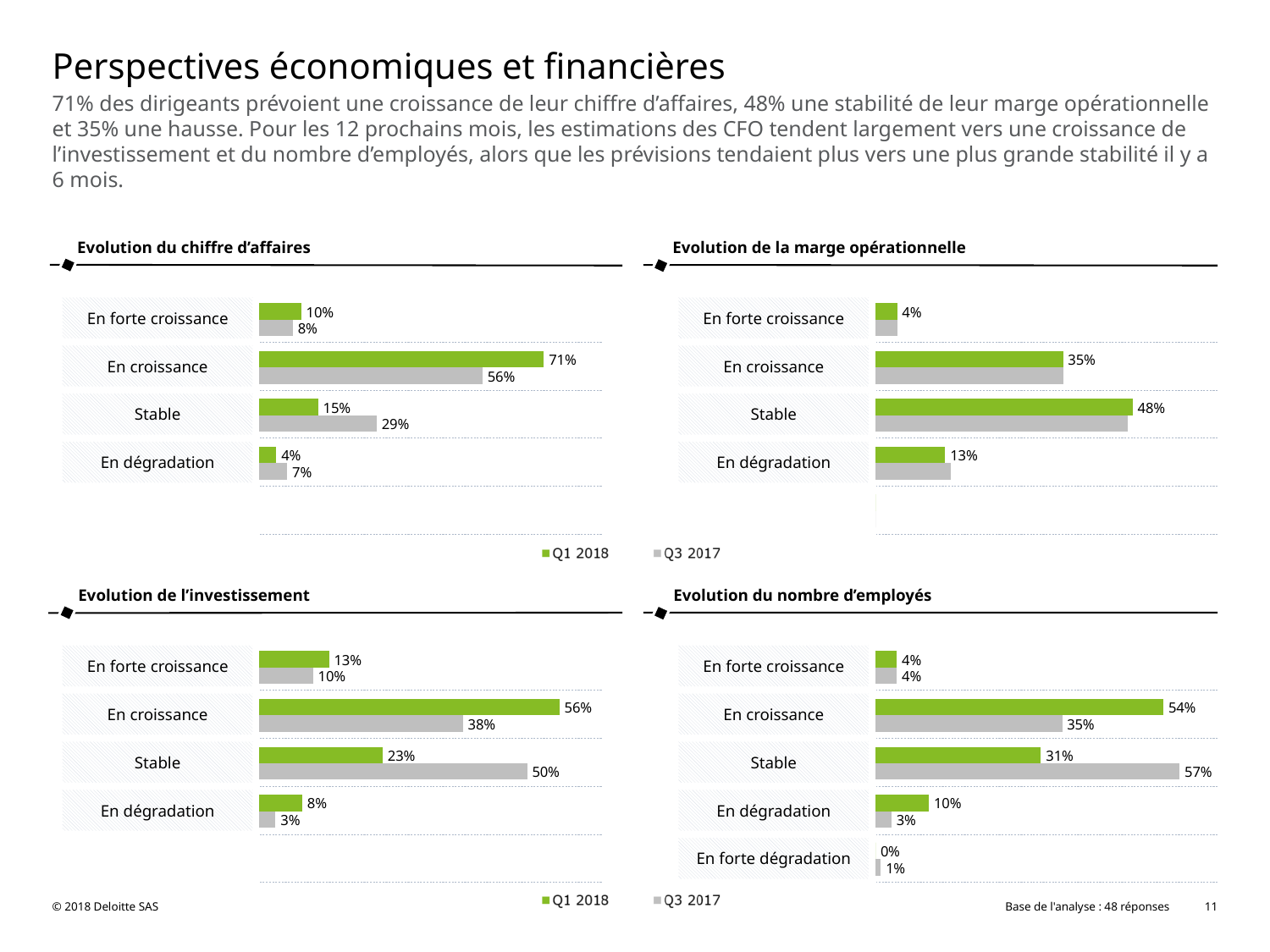
In the 'Evolution du nombre d'employés' chart, what is the Q3 2017 value for 'Stable'? 57% In the 'Evolution de la marge opérationnelle' chart, what is the Q1 2018 value for 'En dégradation'? 13% In the 'Evolution du chiffre d'affaires' chart, what is the Q3 2017 value for 'Stable'? 29% How many series does the legend list for the 'Evolution de l'investissement' chart? 2 In the 'Evolution de la marge opérationnelle' chart, which category has the highest Q1 2018 value? Stable How many categories does the 'Evolution du nombre d'employés' chart show? 5 In the 'Evolution du nombre d'employés' chart, what is the difference between the Q3 2017 and Q1 2018 values for 'Stable'? 26% In the 'Evolution de l'investissement' chart, which is larger for 'En croissance': the Q1 2018 value or the Q3 2017 value? Q1 2018 In the 'Evolution de l'investissement' chart, what is the Q3 2017 value for 'Stable'? 50% What type of chart is the 'Evolution du chiffre d'affaires' chart? Bar chart In the 'Evolution du chiffre d'affaires' chart, what is the difference between the Q1 2018 and Q3 2017 values for 'En croissance'? 15% In the 'Evolution du chiffre d'affaires' chart, what is the Q1 2018 value for 'En croissance'? 71%